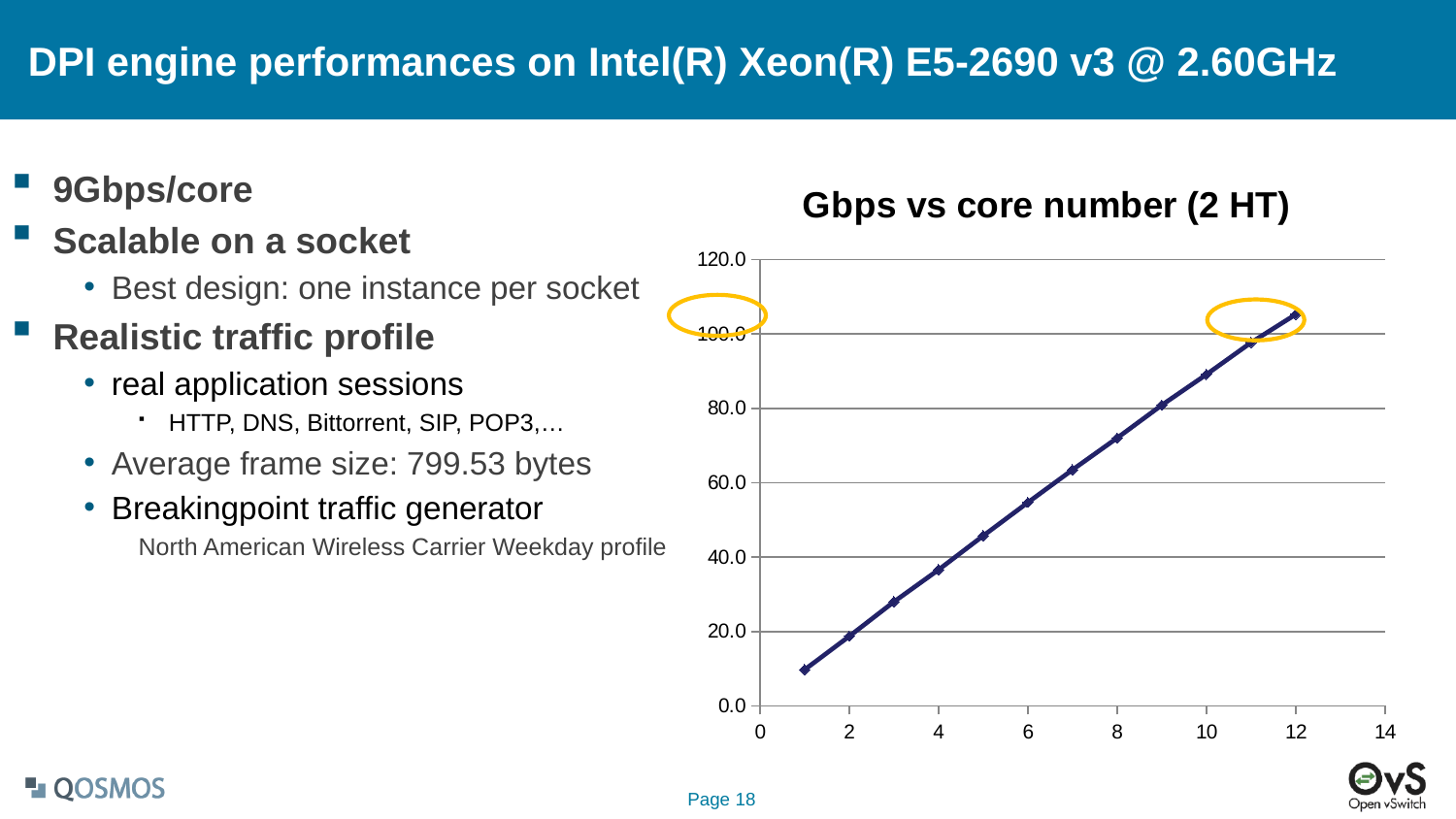
What is the title of the chart? Gbps vs core number (2 HT) Is the value for 10 cores greater or less than 80? greater What kind of chart is shown on the slide? line chart Which core number has the highest Gbps value? 12 Is the value for 8 cores greater or less than 60? greater Which core number has the lowest Gbps value? 1 Is the value for 6 cores greater or less than 60? less How many data points are plotted on the chart? 12 Do the values rise or fall as the core number increases along the x axis? rise Which has the larger Gbps value, 3 cores or 5 cores? 5 cores